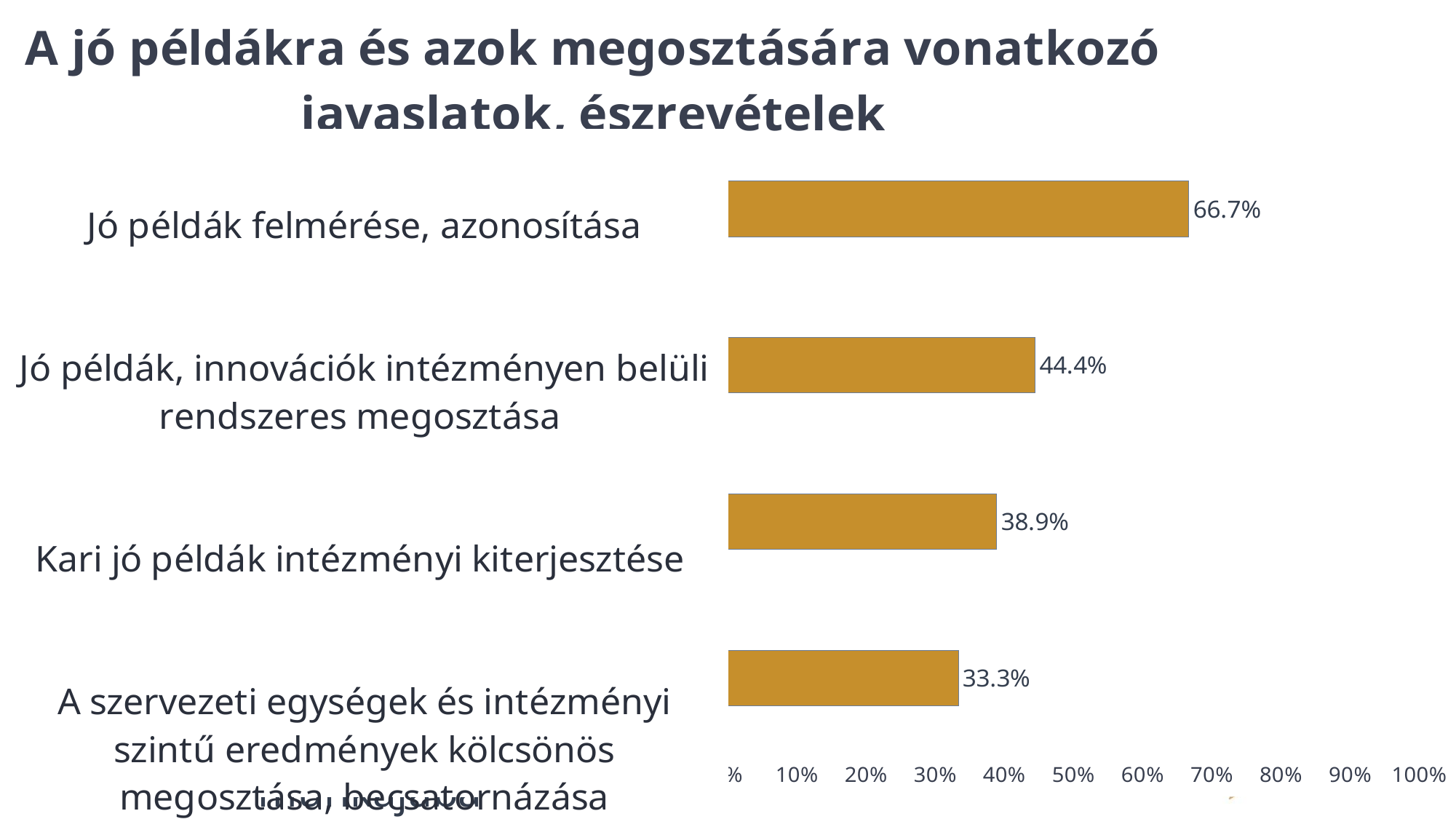
What kind of chart is shown on the slide? bar chart What is the value for "Jó példák felmérése, azonosítása"? 66.7% Which category has the lowest value? A szervezeti egységek és intézményi szintű eredmények kölcsönös megosztása, becsatornázása What is the value for "A szervezeti egységek és intézményi szintű eredmények kölcsönös megosztása, becsatornázása"? 33.3% How many categories are shown in the chart? 4 Which is larger: the value for "Kari jó példák intézményi kiterjesztése" or the value for "A szervezeti egységek és intézményi szintű eredmények kölcsönös megosztása, becsatornázása"? Kari jó példák intézményi kiterjesztése Is the value for "Jó példák, innovációk intézményen belüli rendszeres megosztása" greater or less than 50%? less What is the value for "Jó példák, innovációk intézményen belüli rendszeres megosztása"? 44.4% What is the value for "Kari jó példák intézményi kiterjesztése"? 38.9% What is the maximum value shown on the horizontal axis? 100% What is the difference between the values for "Jó példák felmérése, azonosítása" and "Jó példák, innovációk intézményen belüli rendszeres megosztása"? 22.3% Which category has the highest value? Jó példák felmérése, azonosítása